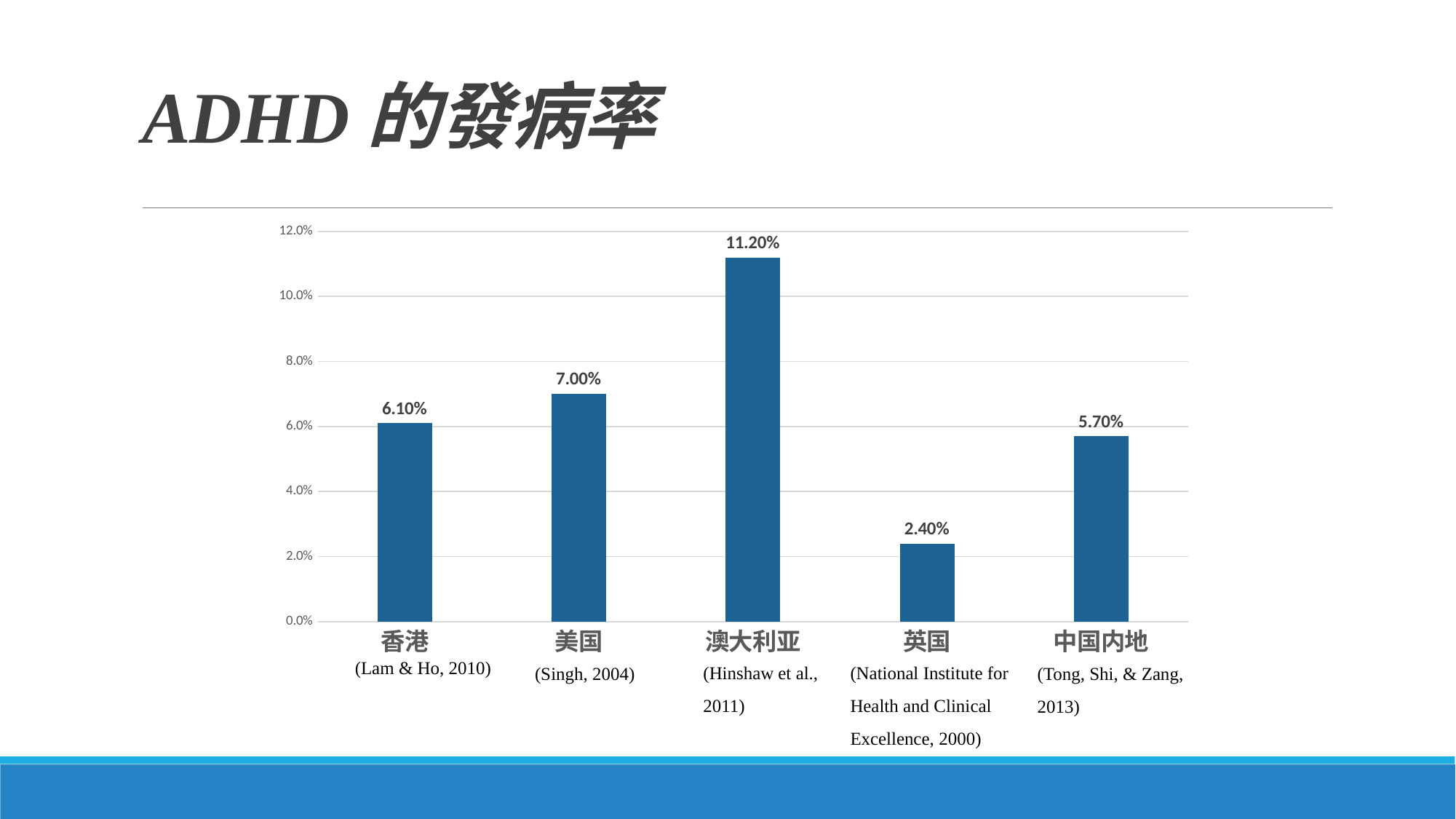
What kind of chart is shown on the slide? Bar chart Which has a larger value, 香港 or 中国内地? 香港 Which category has the lowest value? 英国 What is the value shown for 美国 (United States)? 7.00% What is the difference between the values for 美国 and 香港? 0.90% What is the title of the slide containing the chart? ADHD 的發病率 What is the ADHD prevalence value shown for 香港 (Hong Kong)? 6.10% What is the difference between the values for 澳大利亚 and 英国? 8.80% What is the value shown for 英国 (United Kingdom)? 2.40% What is the value shown for 中国内地 (Mainland China)? 5.70% Which category has the highest value? 澳大利亚 How many categories (bars) are shown in the chart? 5